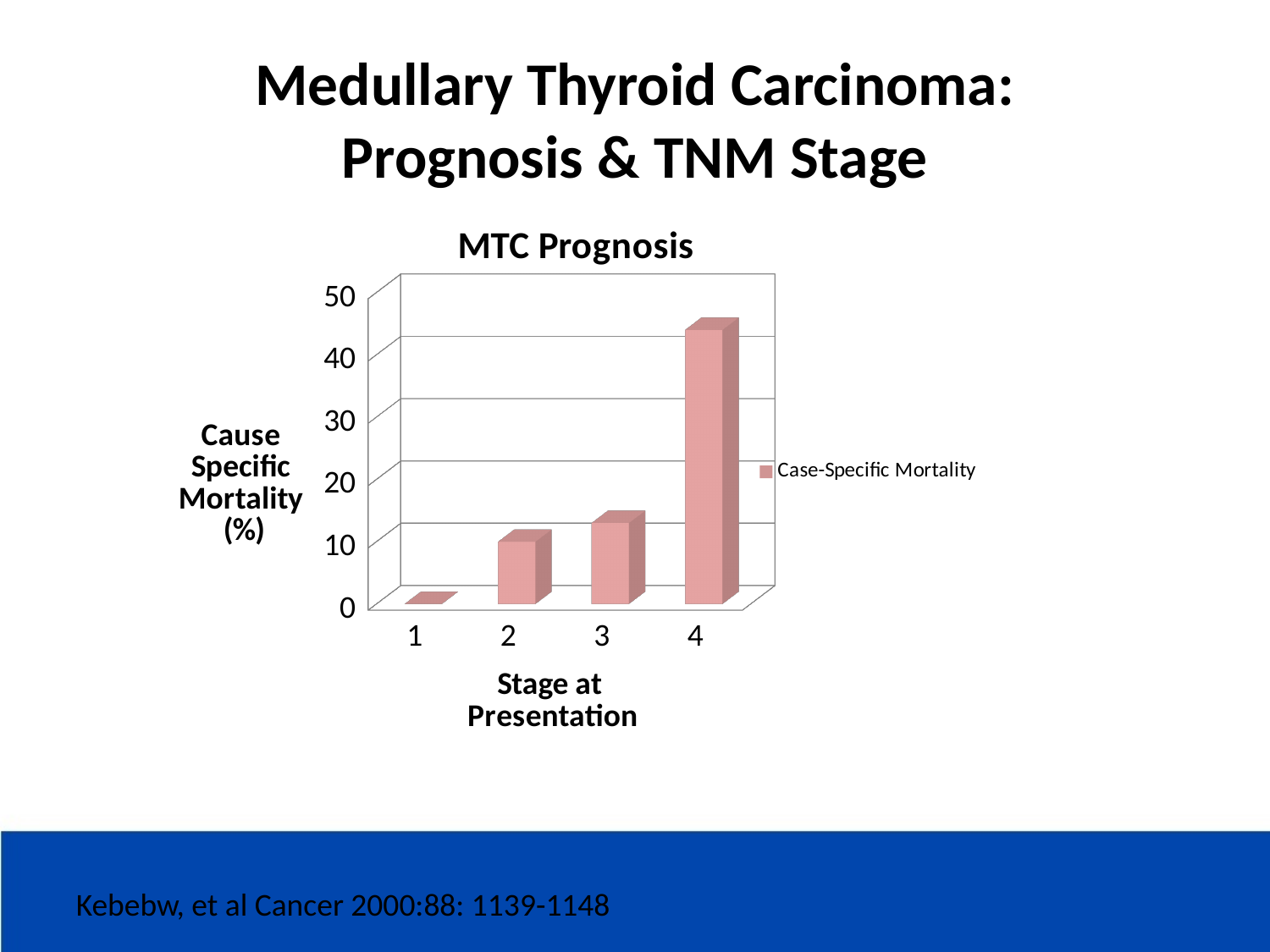
Which stage at presentation has the highest cause specific mortality? 4 How many stages are plotted on the x axis of the chart? 4 What kind of chart is shown on the slide? bar chart Does cause specific mortality rise or fall as the stage at presentation increases from 1 to 4? rise Is the cause specific mortality for stage 3 greater or less than 20? less Is the cause specific mortality for stage 1 greater or less than 10? less What series name is shown in the chart's legend? Case-Specific Mortality Is the cause specific mortality for stage 4 greater or less than 30? greater Which stage at presentation has the lowest cause specific mortality? 1 What is the title of the chart? MTC Prognosis Which has a higher cause specific mortality, stage 2 or stage 4? stage 4 How many series does the chart's legend list? 1